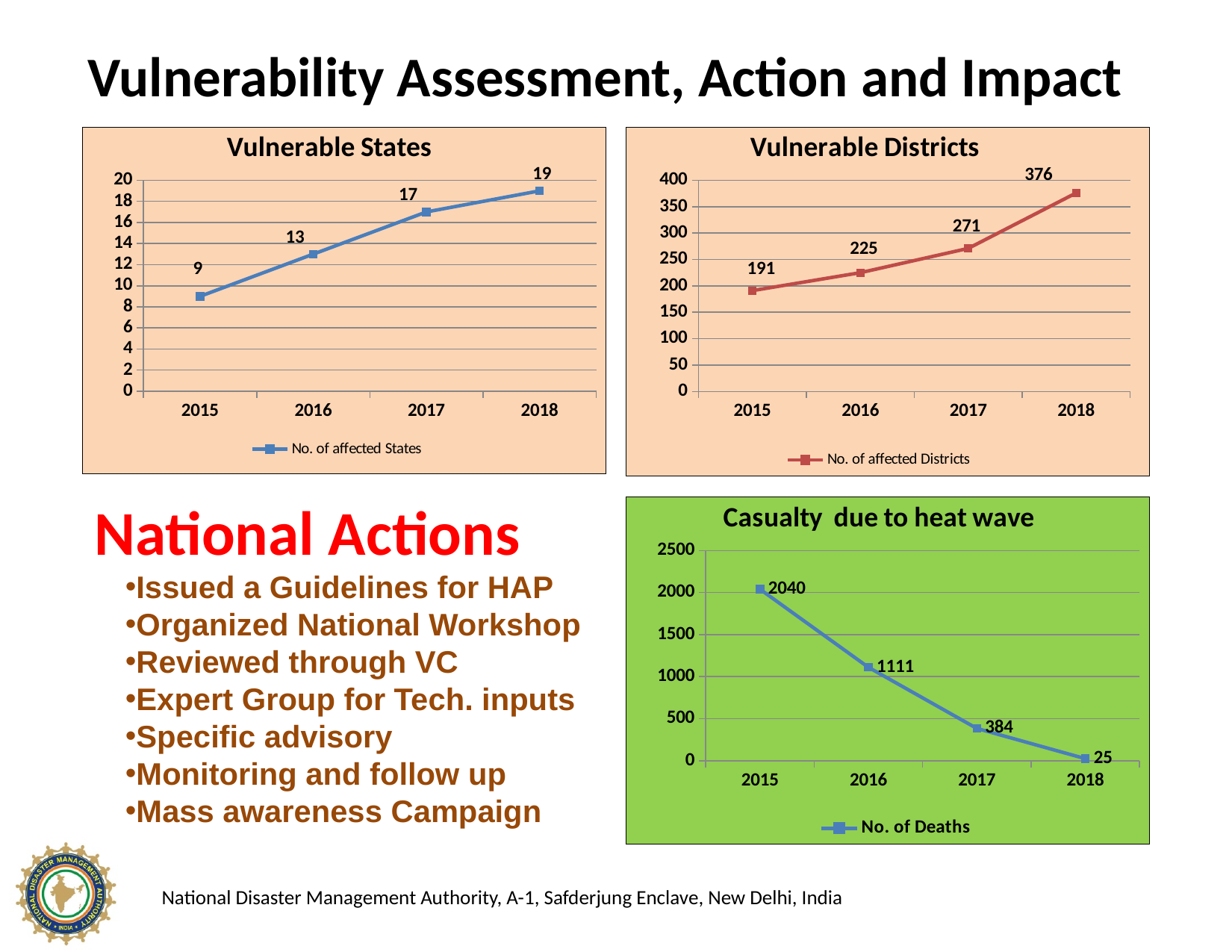
In the 'Casualty due to heat wave' chart, what is the number of deaths in 2016? 1111 In the 'Vulnerable Districts' chart, which year has the lowest number of affected districts? 2015 In the 'Vulnerable Districts' chart, what is the number of affected districts in 2017? 271 In the 'Vulnerable Districts' chart, what is the difference between the values for 2018 and 2017? 105 In the 'Vulnerable Districts' chart, how many years are plotted on the x axis? 4 In the 'Vulnerable States' chart, what is the number of affected states in 2016? 13 In the 'Casualty due to heat wave' chart, which is larger, the value for 2017 or the value for 2018? 2017 In the 'Vulnerable States' chart, which year has the highest number of affected states? 2018 In the 'Vulnerable States' chart, what is the difference between the values for 2018 and 2015? 10 In the 'Vulnerable States' chart, do the values rise or fall from 2015 to 2018? rise In the 'Casualty due to heat wave' chart, do the values rise or fall from 2015 to 2018? fall What kind of chart is the 'Casualty due to heat wave' chart? line chart